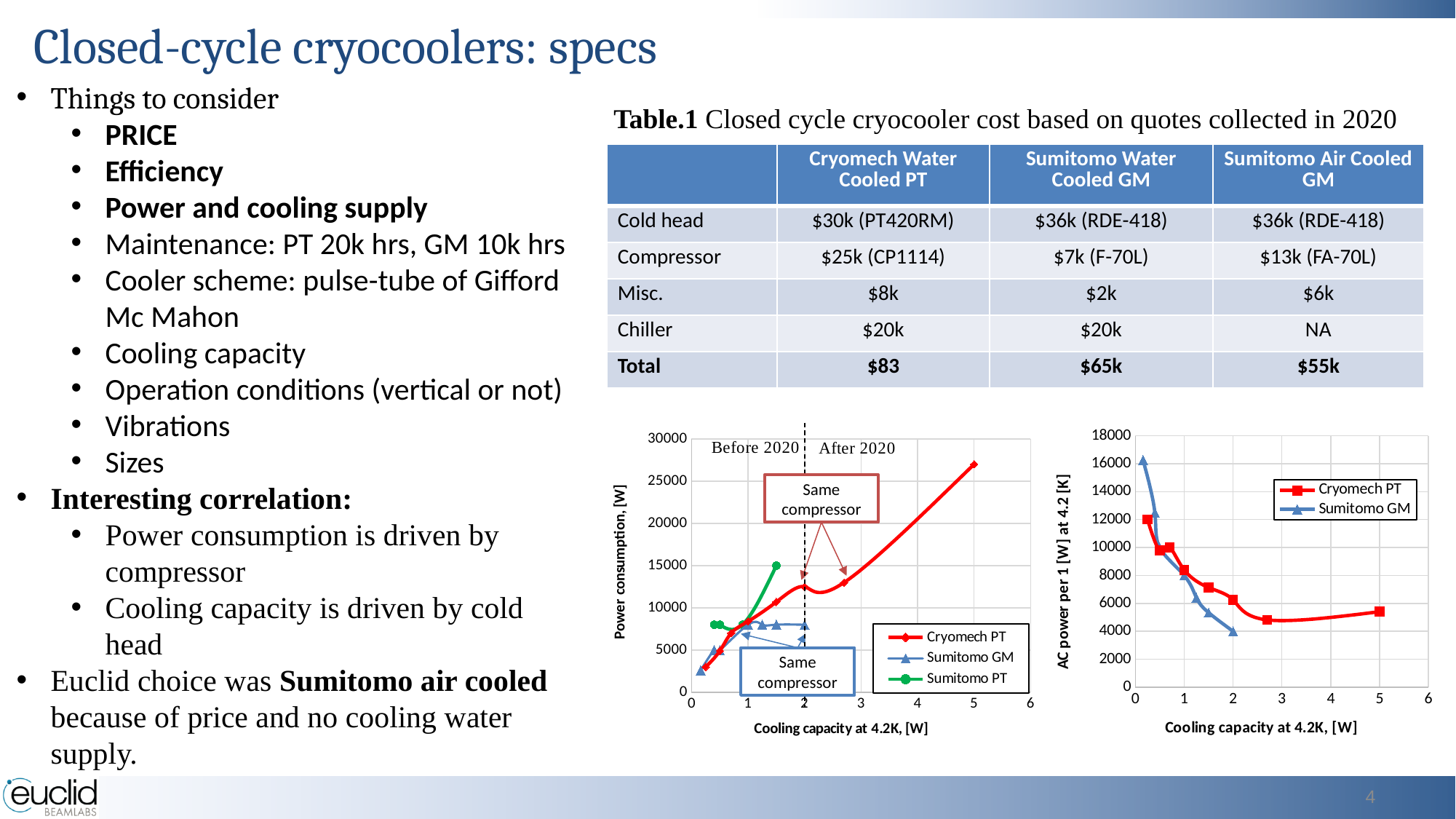
In the left chart, is the power consumption of Sumitomo GM at a cooling capacity of 2 W greater or less than 10000? less In the left chart, is the power consumption of Cryomech PT at a cooling capacity of 5 W greater or less than 25000? greater How many series does the legend of the right chart (AC power per 1 W at 4.2 K) list? 2 What kind of chart is the left chart showing power consumption against cooling capacity? Line chart In the left chart, which series reaches the highest power consumption? Cryomech PT In the right chart, is the AC power per 1 W for Cryomech PT at a cooling capacity of 3 W greater or less than 6000? less In the right chart, at a cooling capacity of 2 W, which series has the higher AC power per 1 W: Cryomech PT or Sumitomo GM? Cryomech PT What is the x-axis title of the right chart? Cooling capacity at 4.2K, [W] In the right chart, does the AC power per 1 W for Cryomech PT rise or fall as cooling capacity increases? Fall In the left chart, does the power consumption of Cryomech PT rise or fall as cooling capacity increases? Rise How many series does the legend of the left chart (Power consumption vs Cooling capacity) list? 3 What is the y-axis title of the left chart? Power consumption, [W]